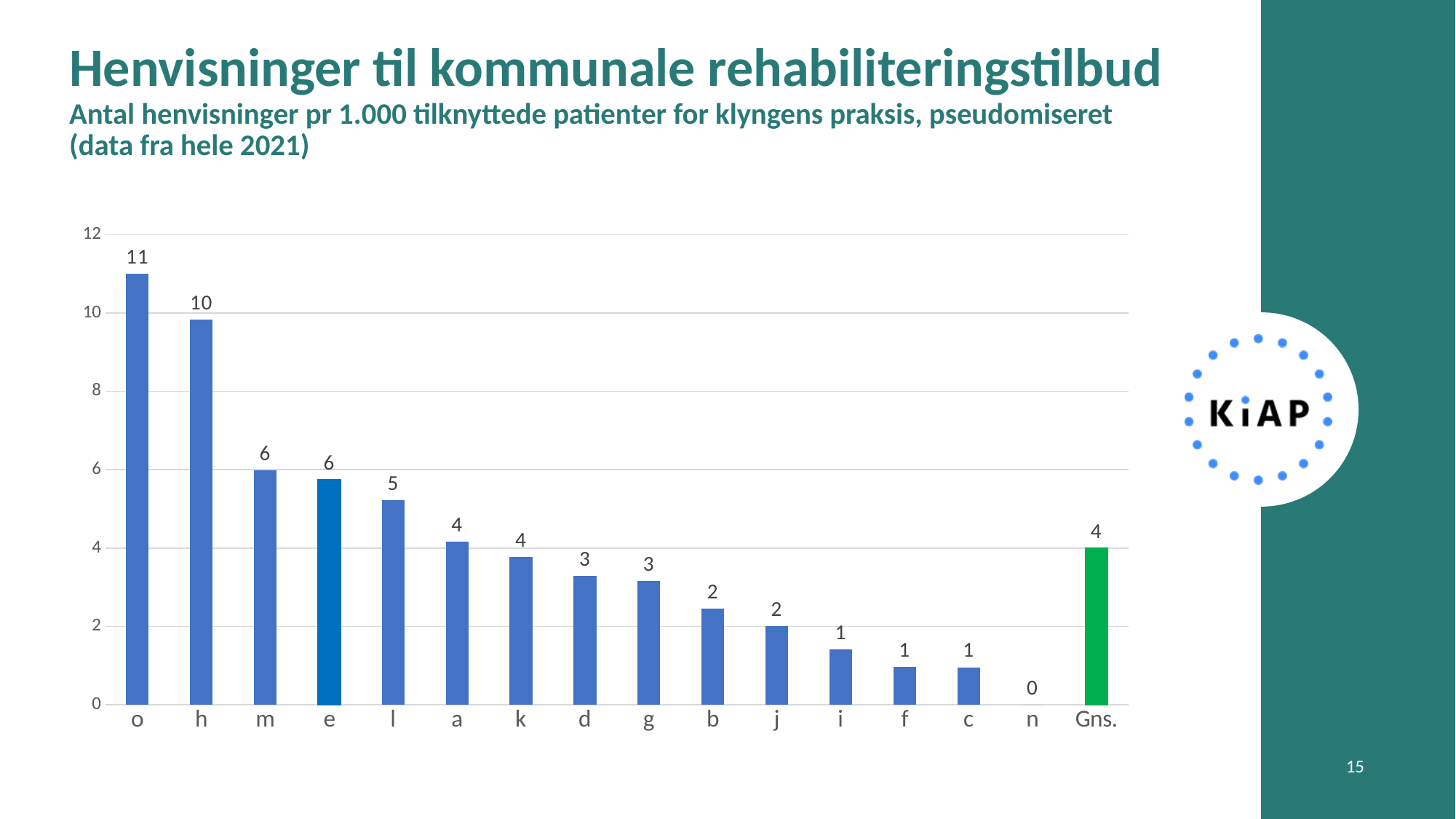
Which category has the lowest value? n What is the value for category n? 0 Which category has the highest value? o What is the difference between the values for o and n? 11 What is the value for category o? 11 Is the value for l greater or less than 6? less Which has the larger value, o or h? o What colour is the Gns. bar? green How many categories are shown on the x axis? 16 What is the value for Gns.? 4 What is the value for category h? 10 What kind of chart is shown on the slide? bar chart